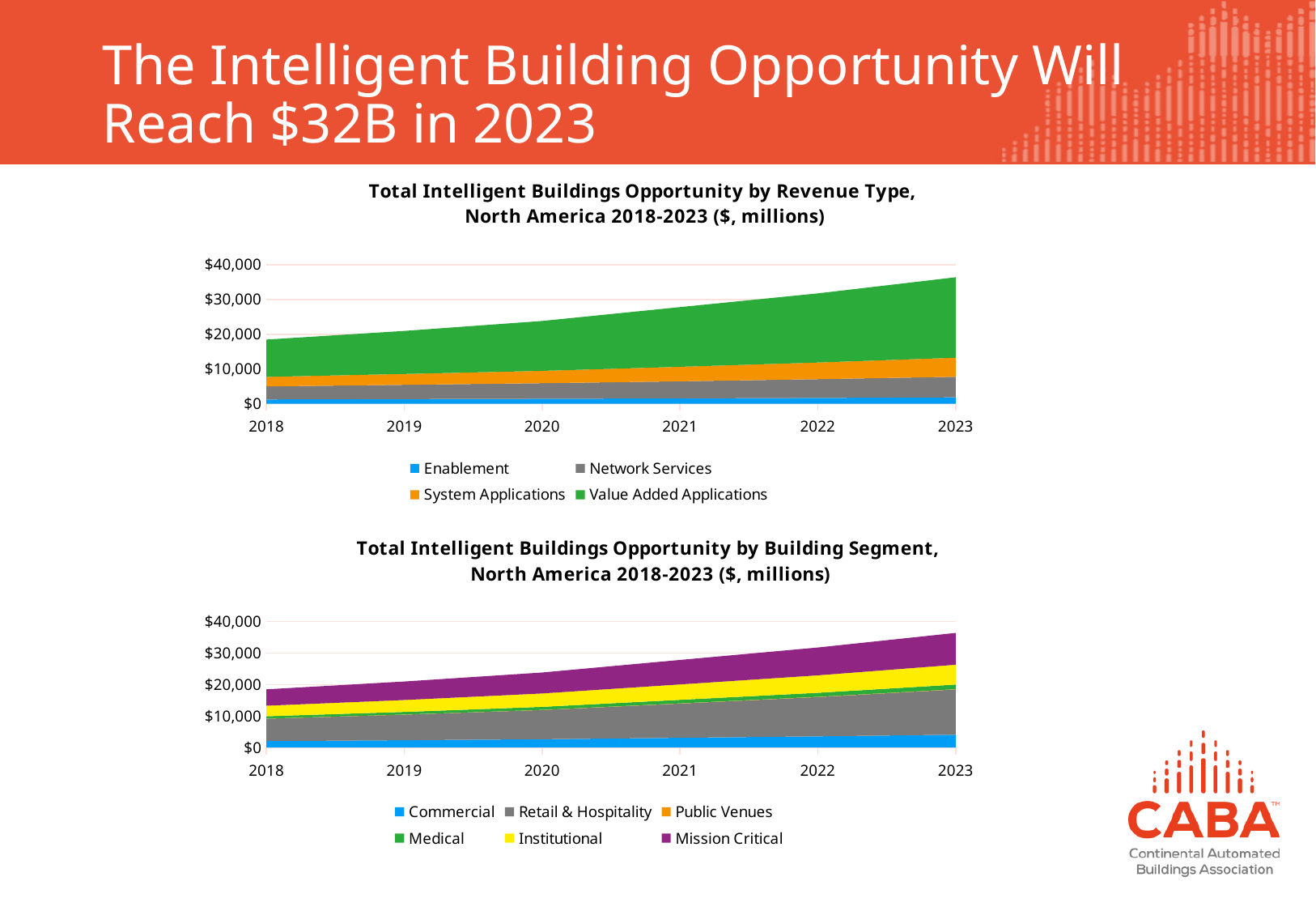
How many series does the legend of the bottom chart (by Building Segment) list? 6 In the bottom chart (by Building Segment), does the total opportunity rise or fall from 2018 to 2023? Rise In the top chart (by Revenue Type), is the total value for 2023 greater or less than $30,000? greater In the bottom chart (by Building Segment), is the total value for 2023 greater or less than $30,000? greater In the top chart (by Revenue Type), is the total value for 2018 greater or less than $20,000? less In the top chart (by Revenue Type), does the total opportunity rise or fall from 2018 to 2023? Rise In the bottom chart (by Building Segment), which colour represents Mission Critical in the legend? Purple In the top chart (by Revenue Type), which series accounts for the largest share of the opportunity in 2023? Value Added Applications How many years are shown on the x axis of the top chart (by Revenue Type)? 6 How many series does the legend of the top chart (by Revenue Type) list? 4 What kind of chart is the top chart, 'Total Intelligent Buildings Opportunity by Revenue Type'? Stacked area chart